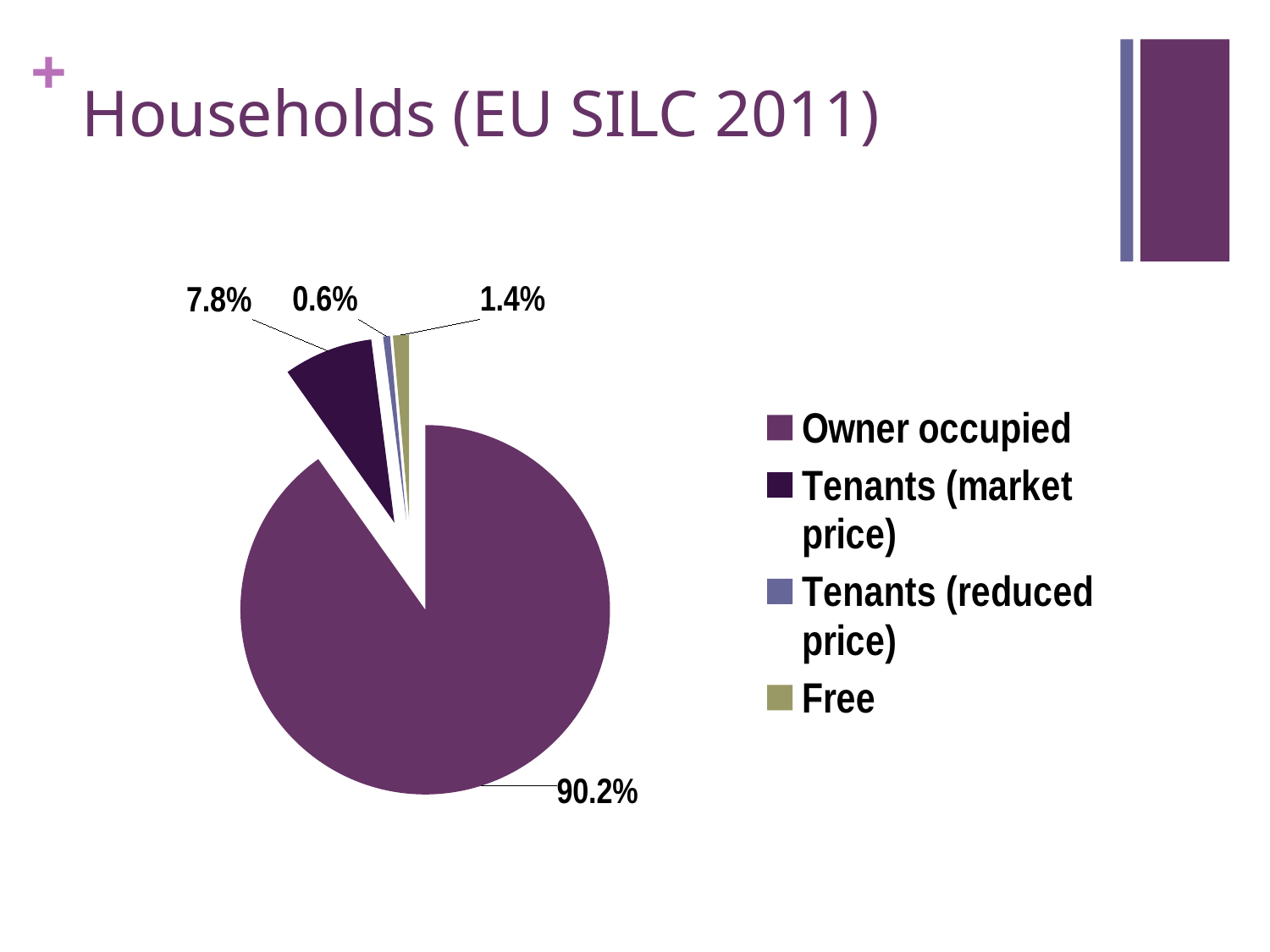
Which is larger, the share for Free or the share for Tenants (reduced price)? Free How many categories does the pie chart show? 4 What share of households is Tenants (market price)? 7.8% Which legend entry is shown in the olive/khaki colour? Free What is the difference in percentage points between Owner occupied and Tenants (market price)? 82.4 What kind of chart is shown on the slide? Pie chart What is the title of the slide? Households (EU SILC 2011) What share of households is Owner occupied? 90.2% Which category has the largest share of the pie? Owner occupied What share of households is Free? 1.4% What share of households is Tenants (reduced price)? 0.6% Which category has the smallest share of the pie? Tenants (reduced price)